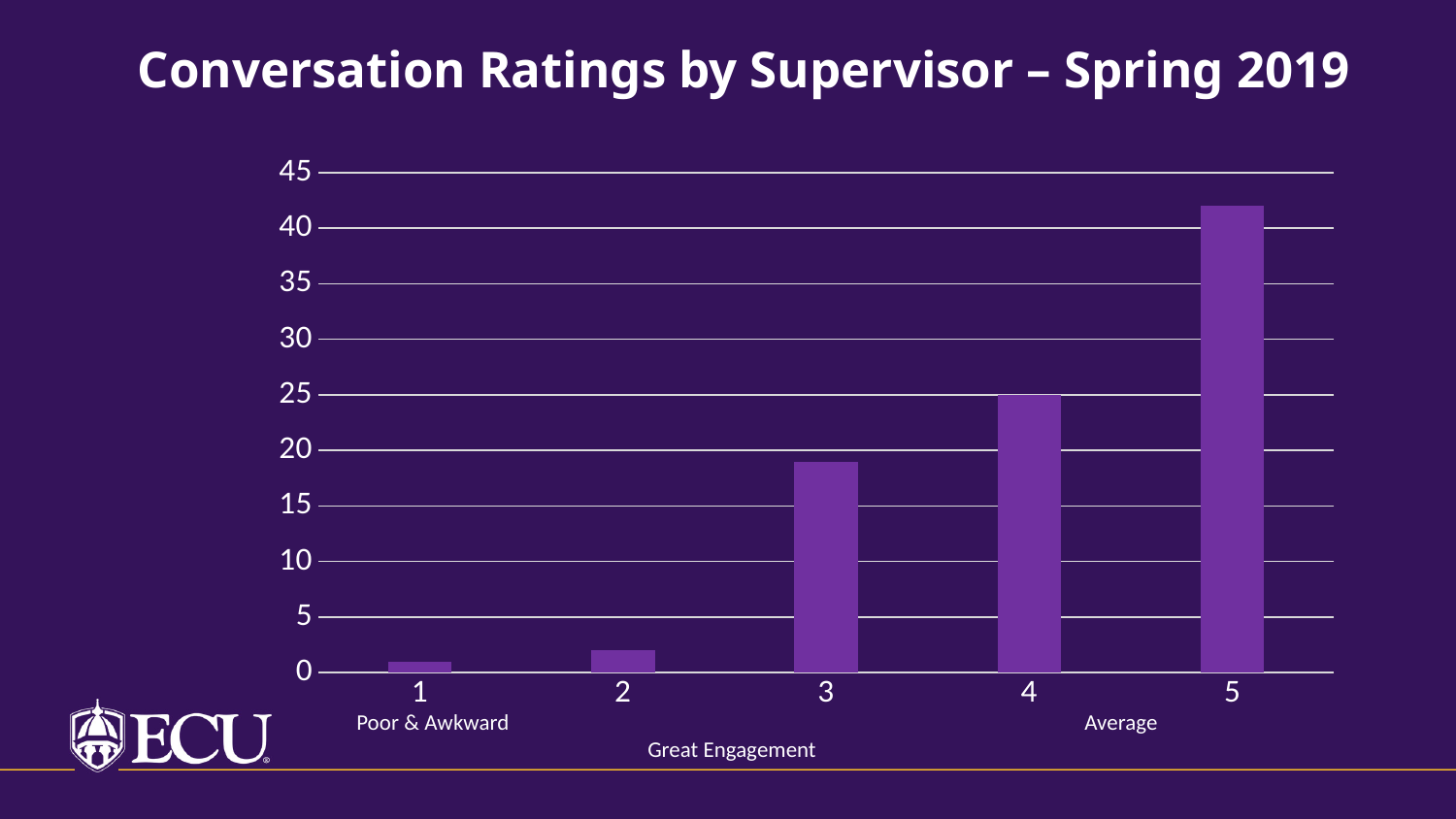
Do the values rise or fall as the rating category increases from 1 to 5? rise Is the value for rating category 5 greater or less than 40? greater Is the value for rating category 2 greater or less than 5? less What kind of chart is shown on the slide? bar chart What text label appears beneath rating category 1 on the x axis? Poor & Awkward What is the title of the chart? Conversation Ratings by Supervisor – Spring 2019 Which rating category has the lowest value? 1 What is the value for rating category 4? 25 Which rating category has the highest value? 5 Is the value for rating category 3 greater or less than 20? less Which has the larger value, rating category 3 or rating category 4? 4 How many rating categories are shown on the x axis? 5